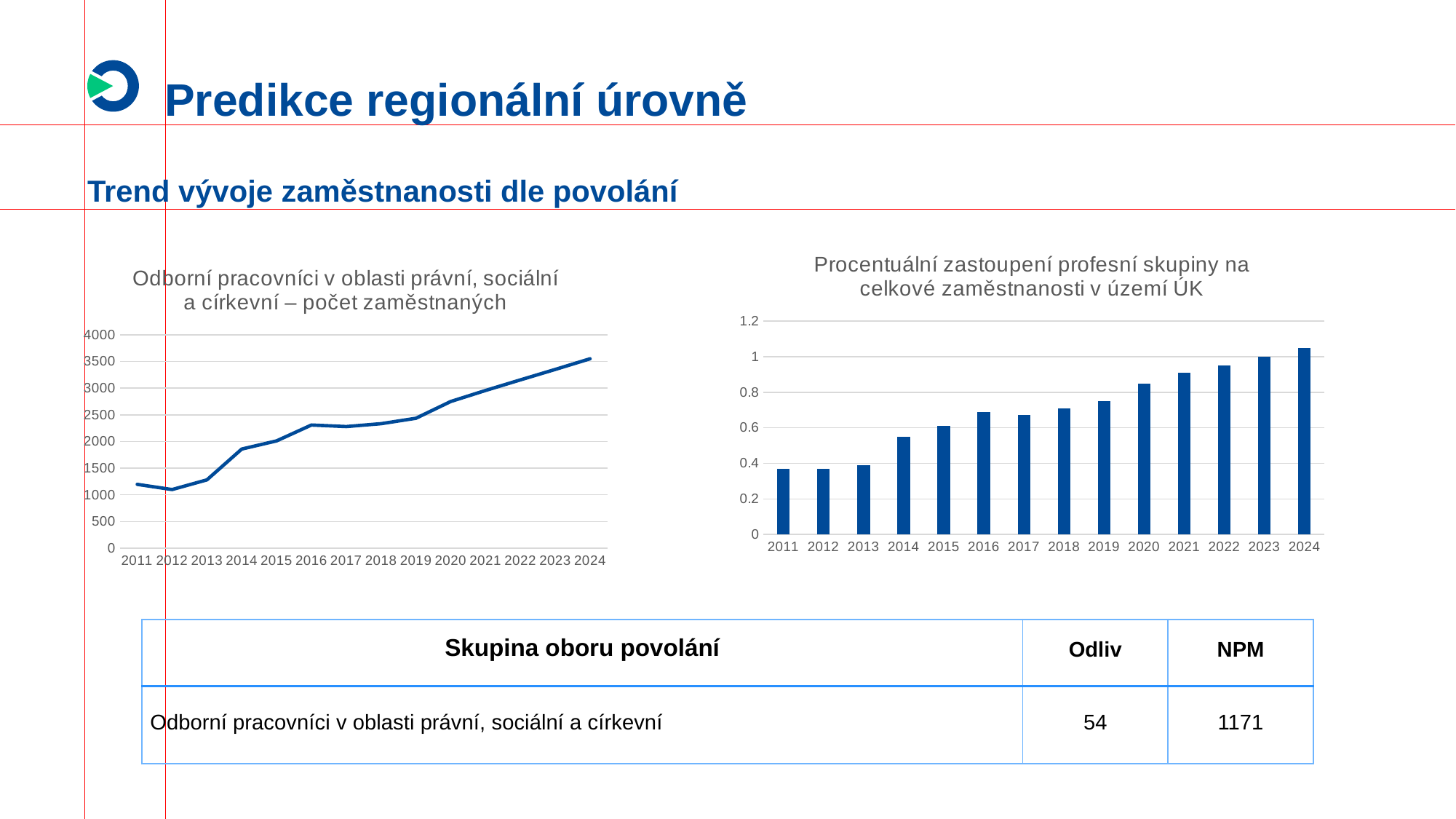
In the right chart (Procentuální zastoupení), is the value for 2020 greater or less than 0.8? greater In the left chart (počet zaměstnaných), which year has the lowest value? 2012 What kind of chart is the right chart titled "Procentuální zastoupení profesní skupiny na celkové zaměstnanosti v území ÚK"? bar chart In the right chart (Procentuální zastoupení), which is larger, the value for 2013 or the value for 2014? 2014 In the right chart (Procentuální zastoupení), which year has the highest value? 2024 What kind of chart is the left chart titled "Odborní pracovníci v oblasti právní, sociální a církevní – počet zaměstnaných"? line chart In the left chart (počet zaměstnaných), which year has the highest value? 2024 In the left chart (počet zaměstnaných), do the values generally rise or fall from 2011 to 2024? rise In the left chart (počet zaměstnaných), how many years are shown on the x axis? 14 In the right chart (Procentuální zastoupení), is the value for 2011 greater or less than 0.4? less In the left chart (počet zaměstnaných), is the value for 2011 greater or less than 1500? less